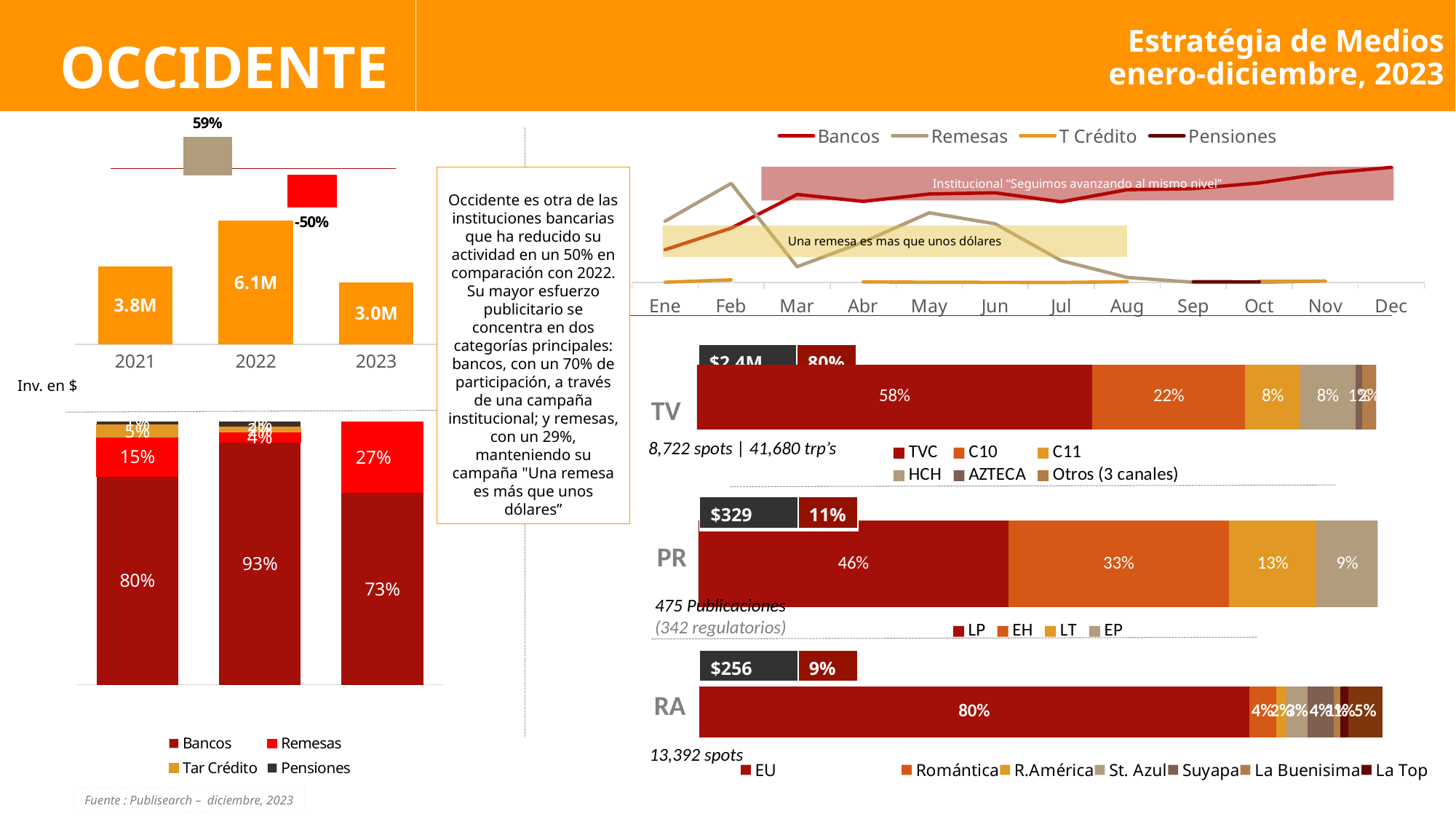
In the 'Inv. en $' bar chart on the left, what is the value for 2022? 6.1M In the PR stacked bar on the right, what is the difference between the LP share and the EH share? 13% In the TV stacked bar on the right, what share does TVC have? 58% In the stacked bar chart at the bottom left, what share does Remesas have in 2023? 27% In the RA stacked bar on the right, which station has the largest share? EU In the PR stacked bar on the right, which is larger, LT or EP? LT In the stacked bar chart at the bottom left, what share does Bancos have in 2022? 93% In the 'Inv. en $' bar chart on the left, which year has the lowest investment? 2023 In the line chart at the top right, how many series does the legend list? 4 In the 'Inv. en $' bar chart on the left, how many years are shown? 3 In the 'Inv. en $' bar chart on the left, which year has the highest investment? 2022 In the stacked bar chart at the bottom left, how many series does the legend list? 4